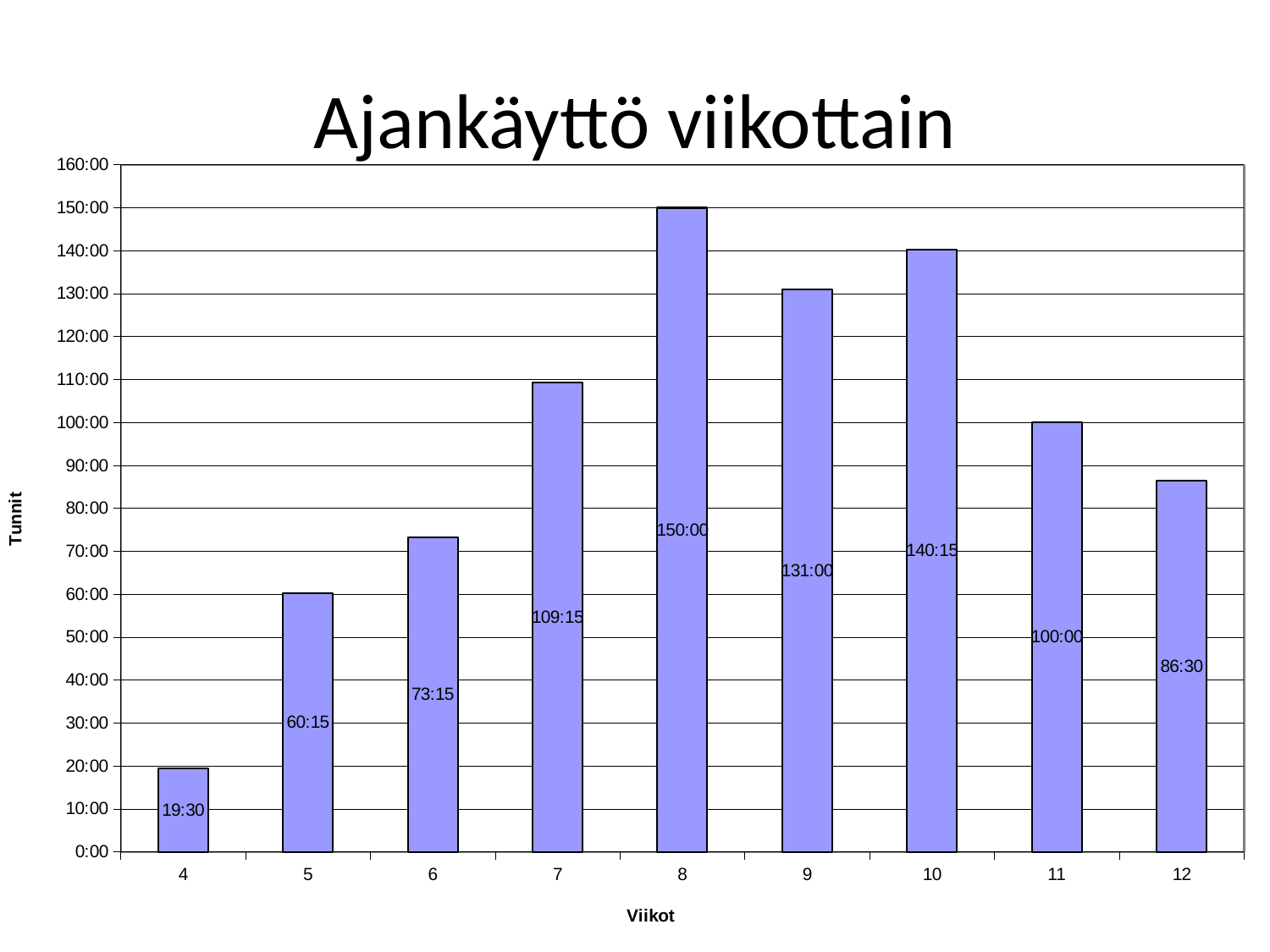
Which is larger, the value for week 9 or the value for week 10? week 10 What is the difference between the values for week 8 and week 9? 19:00 What is the value for week 12? 86:30 Which week has the lowest value? 4 Is the value for week 7 greater or less than 100:00? greater What is the value for week 5? 60:15 What is the difference between the values for week 10 and week 11? 40:15 How many weeks are shown on the x axis? 9 Which week has the highest value? 8 What is the title of the chart? Ajankäyttö viikottain What kind of chart is shown on the slide? bar chart What is the value for week 8? 150:00